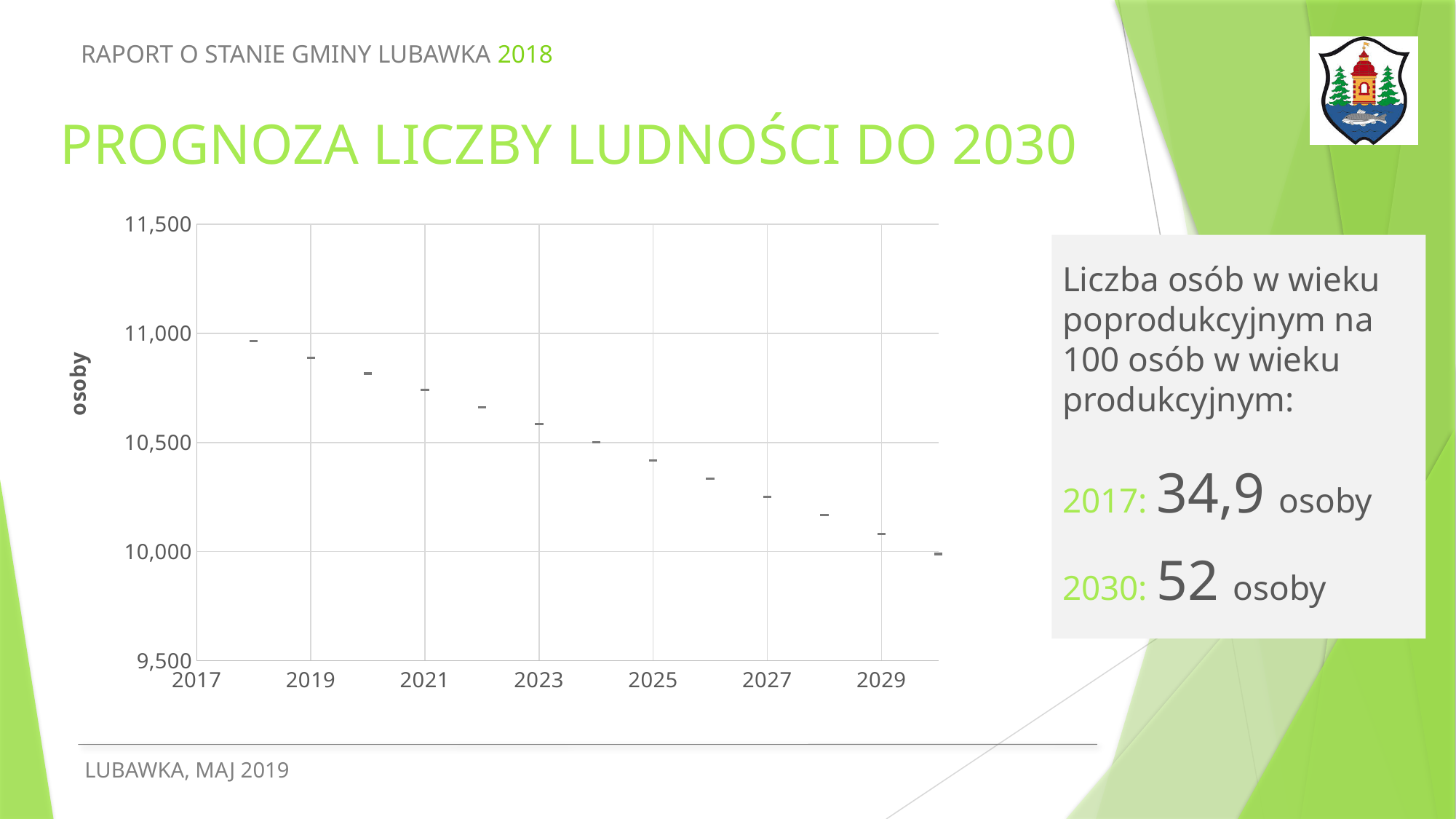
How many data points are plotted on the chart? 13 Is the value for 2028 greater or less than 10,500? less Which year has the larger plotted value, 2019 or 2029? 2019 Is the value for 2019 greater or less than 10,500? greater What is the highest value shown on the vertical axis? 11,500 Is the value for 2018 greater or less than 11,000? less Which year has the lowest plotted value? 2030 What is the title of the vertical axis? osoby Which year has the highest plotted value? 2018 Do the plotted values rise or fall from left to right along the x axis? fall